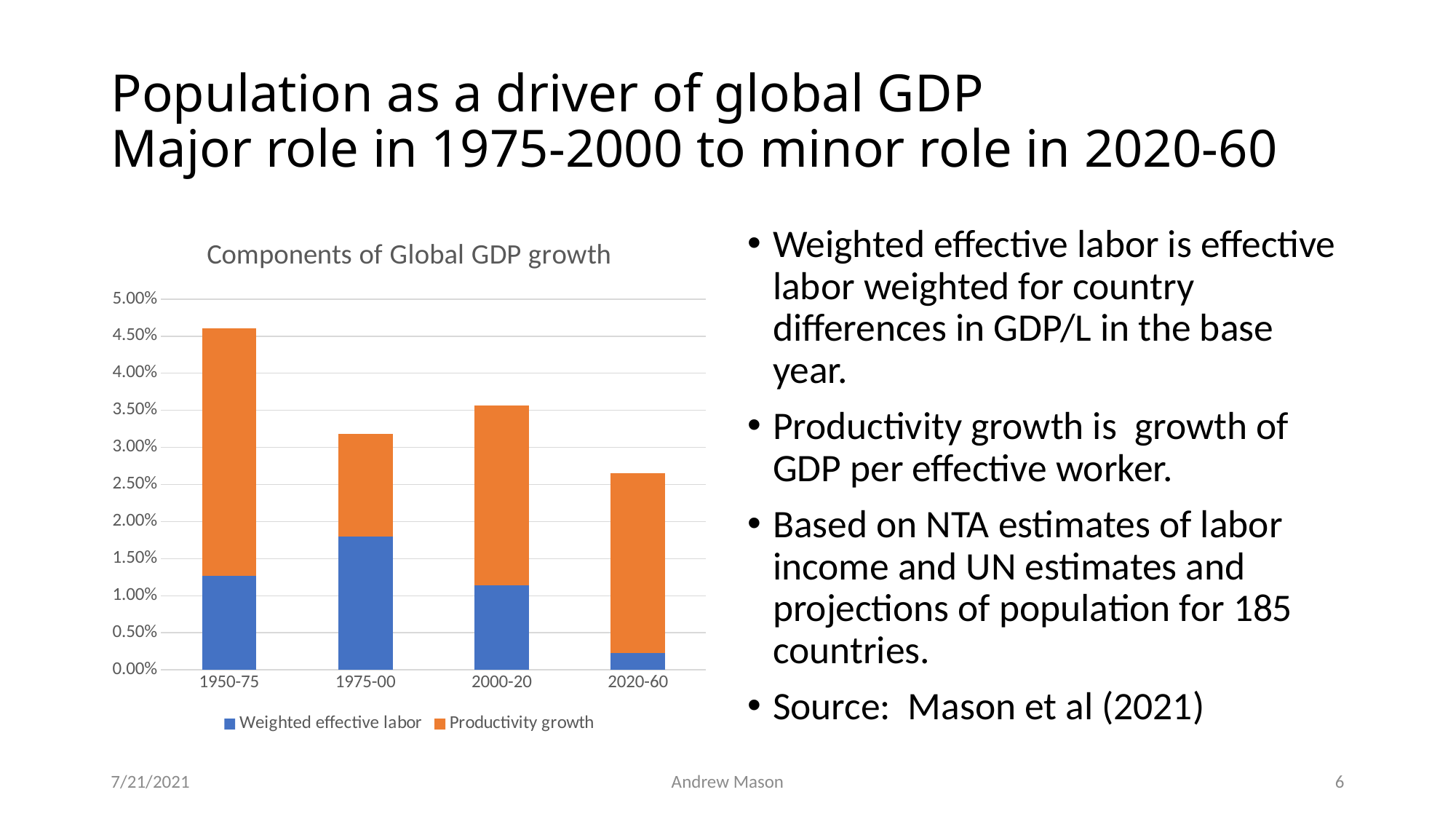
Which period has the highest total global GDP growth in the chart? 1950-75 Which period has the lowest total global GDP growth in the chart? 2020-60 How many series does the chart's legend list? 2 Which period has the smallest Weighted effective labor component? 2020-60 What kind of chart is shown on the slide? Stacked bar chart Is the total bar height for 1950-75 greater or less than 4.00%? greater How many periods are shown on the x axis of the chart? 4 Which colour represents Productivity growth in the chart? Orange Which period has a taller total bar, 1975-00 or 2000-20? 2000-20 Which period has the largest Weighted effective labor component? 1975-00 Is the Weighted effective labor value for 2020-60 greater or less than 0.50%? less What is the title of the chart? Components of Global GDP growth